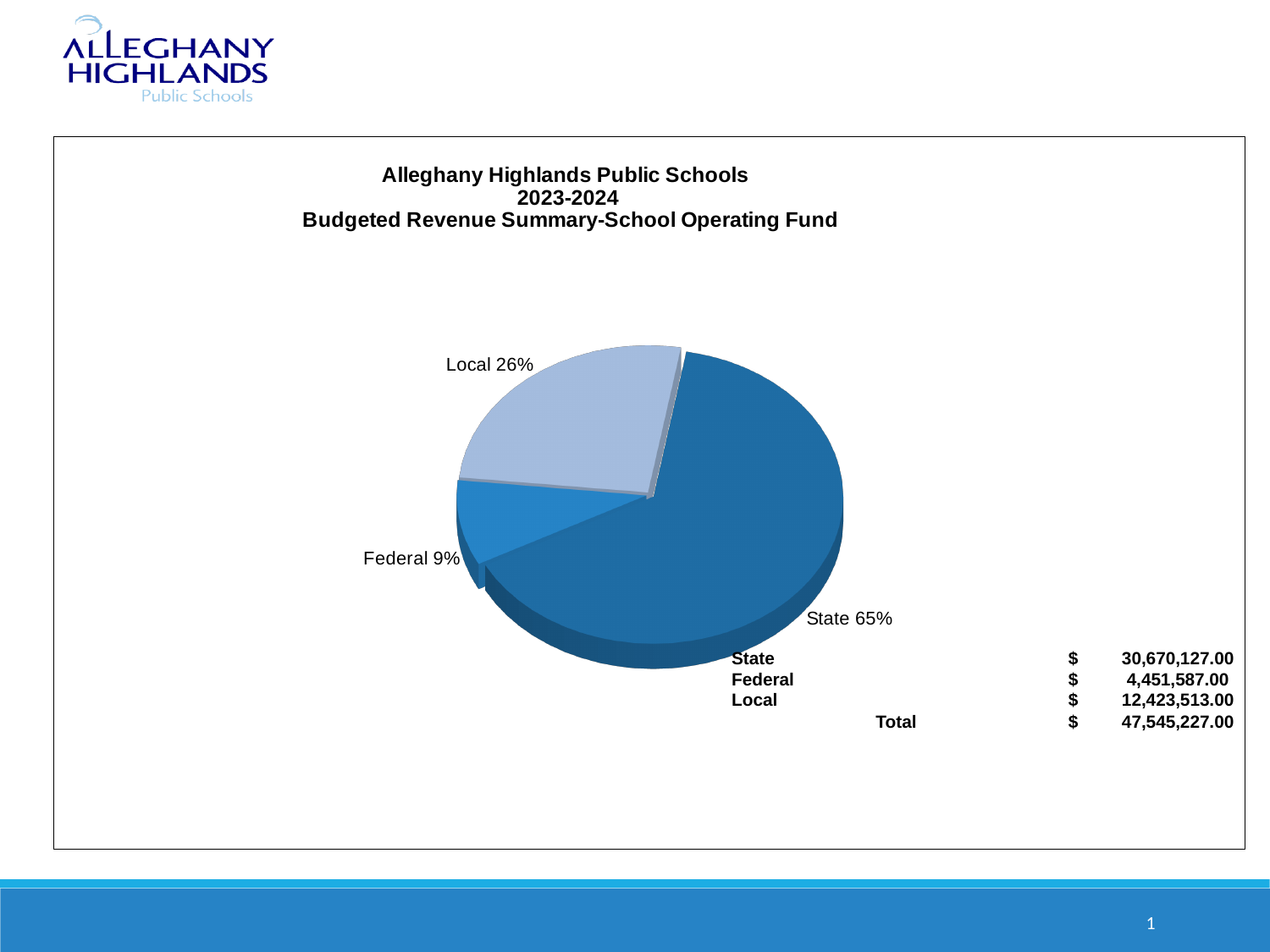
Which category has the smallest slice of the pie? Federal Which is larger, the Local share or the Federal share? Local What is the title of the chart? Alleghany Highlands Public Schools 2023-2024 Budgeted Revenue Summary-School Operating Fund What is the total budgeted revenue shown on the slide? $ 47,545,227.00 What is the difference in percentage points between the State share and the Local share? 39 What is the budgeted State revenue amount shown on the slide? $ 30,670,127.00 How many slices does the pie chart have? 3 What share of the pie does Local represent? 26% What kind of chart is shown on the slide? pie chart Which category has the largest slice of the pie? State What share of the pie does Federal represent? 9% What share of the pie does State represent? 65%